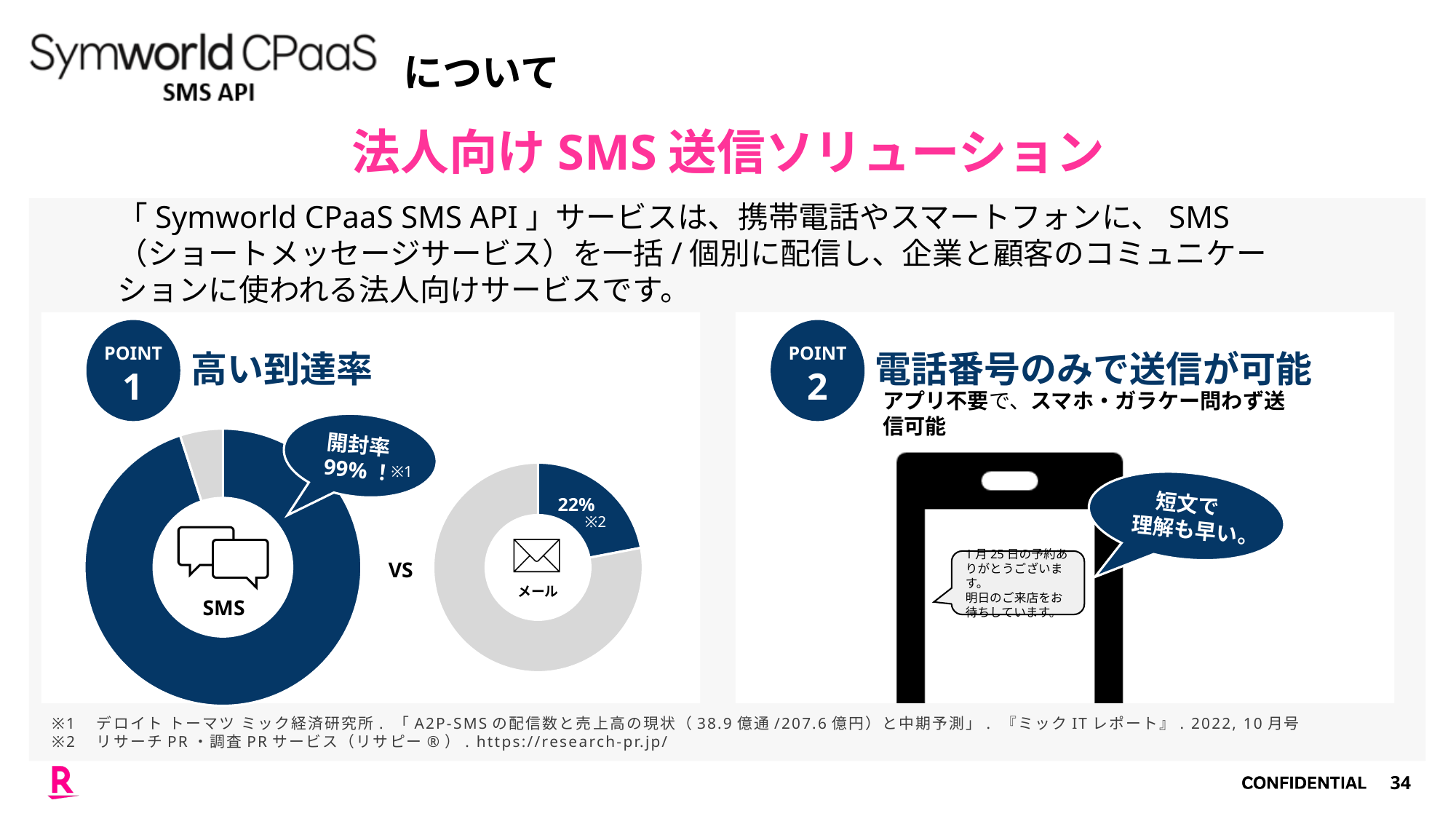
Is the open rate shown for メール greater or less than 50%? less What kind of chart is used to show the SMS and メール open rates? Donut (pie) chart Which has the higher open rate in the donut charts, SMS or メール? SMS What open rate (開封率) is shown for SMS in the left donut chart? 99% Which channel has the lowest open rate in the donut charts? メール By how many percentage points does the SMS open rate exceed the メール open rate? 77 percentage points What open rate is shown for メール (email) in the right donut chart? 22% What word appears between the two donut charts? VS How many donut charts are shown under POINT 1? 2 What is the heading of POINT 1 above the donut charts? 高い到達率 Is the open rate shown for SMS greater or less than 90%? greater